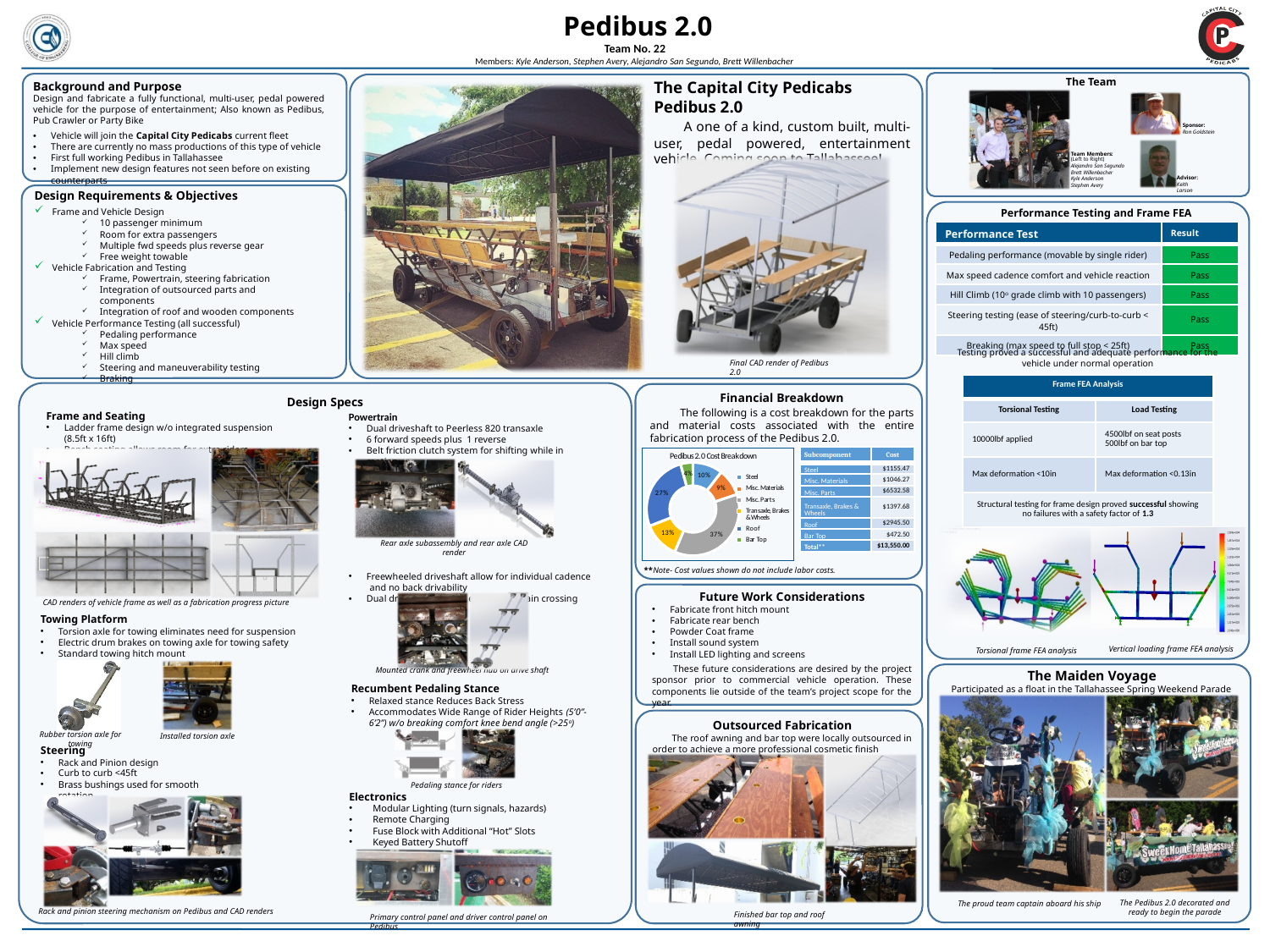
What is the first category listed in the legend of the Pedibus 2.0 Cost Breakdown pie chart? Steel What kind of chart is the Pedibus 2.0 Cost Breakdown chart? doughnut chart Which category has the largest slice in the Pedibus 2.0 Cost Breakdown pie chart? Misc. Parts In the Pedibus 2.0 Cost Breakdown pie chart, which slice is larger: Misc. Parts or Roof? Misc. Parts How many categories does the legend of the Pedibus 2.0 Cost Breakdown pie chart list? 6 Which category has the smallest slice in the Pedibus 2.0 Cost Breakdown pie chart? Bar Top What is the title of the pie chart in the Financial Breakdown section? Pedibus 2.0 Cost Breakdown What percentage is shown on the largest slice of the Pedibus 2.0 Cost Breakdown pie chart? 37% What percentage is shown on the smallest slice of the Pedibus 2.0 Cost Breakdown pie chart? 4%